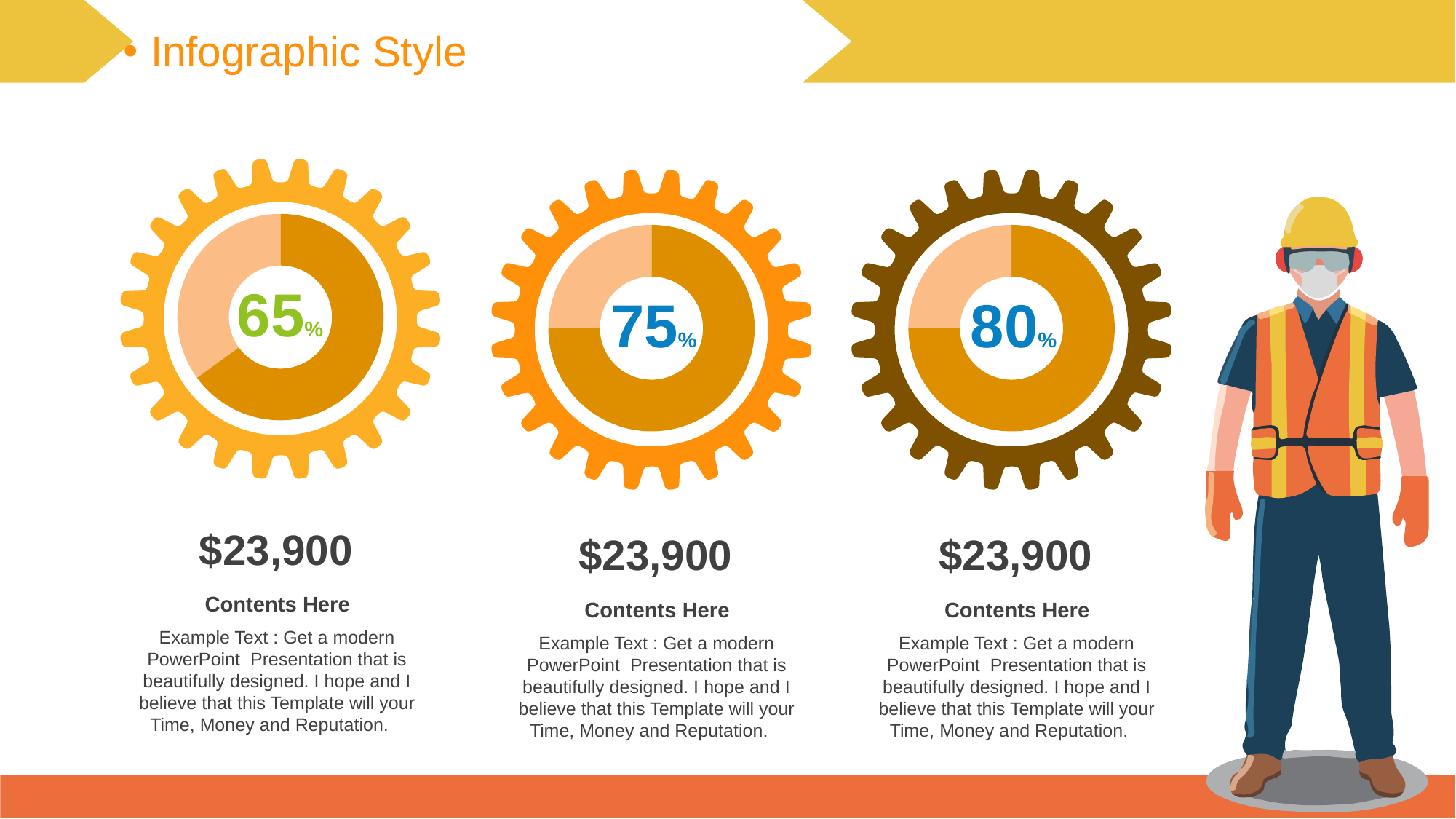
How many gear charts are on the slide? 3 What dollar amount is printed below the middle gear chart? $23,900 What colour is the percentage text in the left gear chart? Green What kind of chart is used inside each gear? Donut (ring) chart Which of the three gear charts shows the lowest percentage? The left chart (65%) What is the difference between the percentage in the middle gear chart and the percentage in the left gear chart? 10% What percentage is shown in the center of the right gear chart? 80% What is the difference between the percentage in the right gear chart and the percentage in the left gear chart? 15% What percentage is shown in the center of the middle gear chart? 75% Which shows a larger percentage, the middle gear chart or the right gear chart? The right gear chart Which of the three gear charts shows the highest percentage? The right chart (80%) What percentage is shown in the center of the left gear chart? 65%